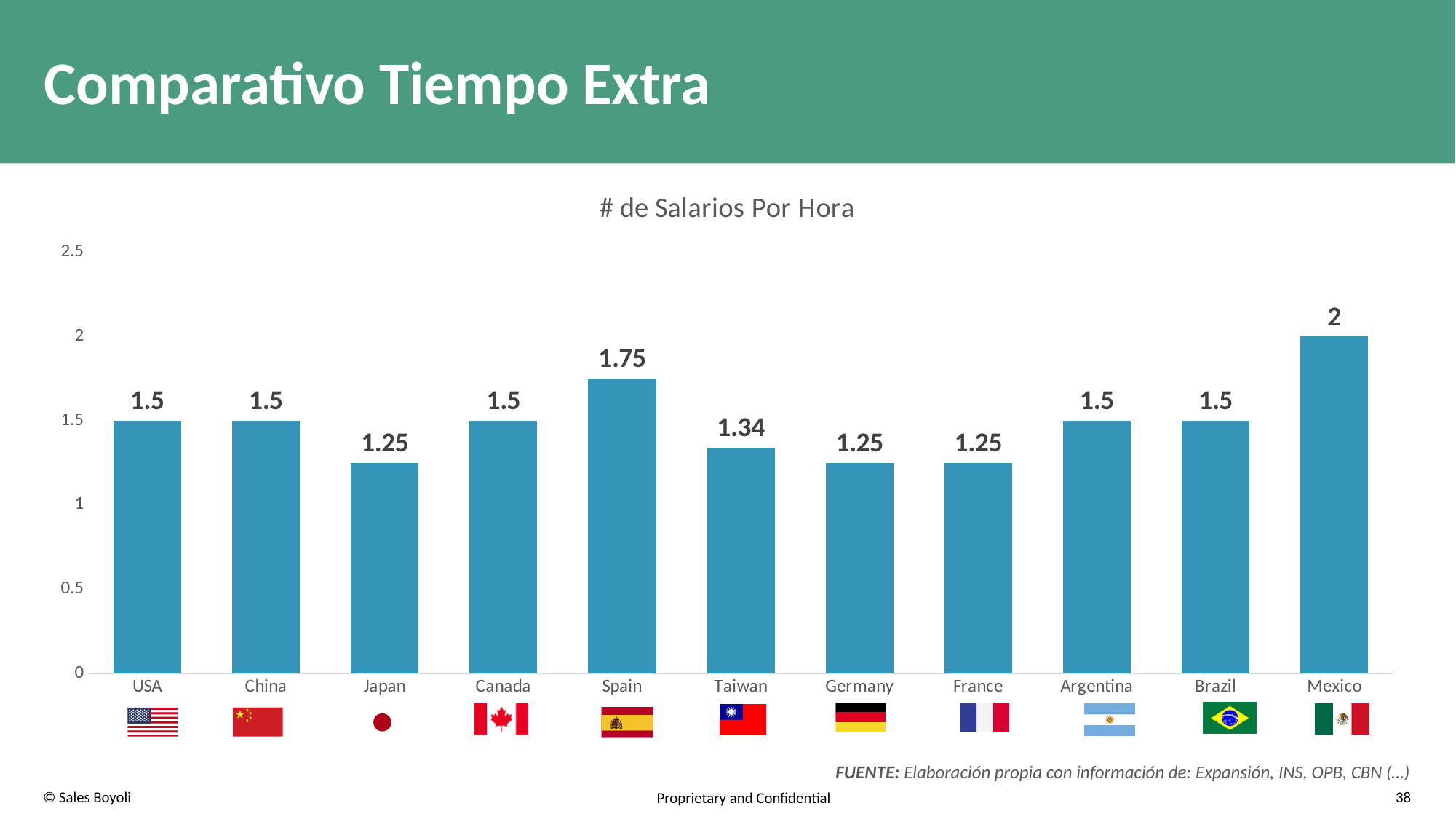
How many countries have a value of 1.25? 3 What kind of chart is this? Bar chart Which is larger, the value for Taiwan or the value for France? Taiwan What is the value for Spain? 1.75 What is the value for Taiwan? 1.34 What is the difference between the values for Mexico and Spain? 0.25 Which country has the highest value? Mexico How many countries are shown on the x axis? 11 What is the title of the chart? # de Salarios Por Hora Which is larger, the value for Spain or the value for Canada? Spain What is the difference between the values for Taiwan and Germany? 0.09 What is the value for Mexico? 2